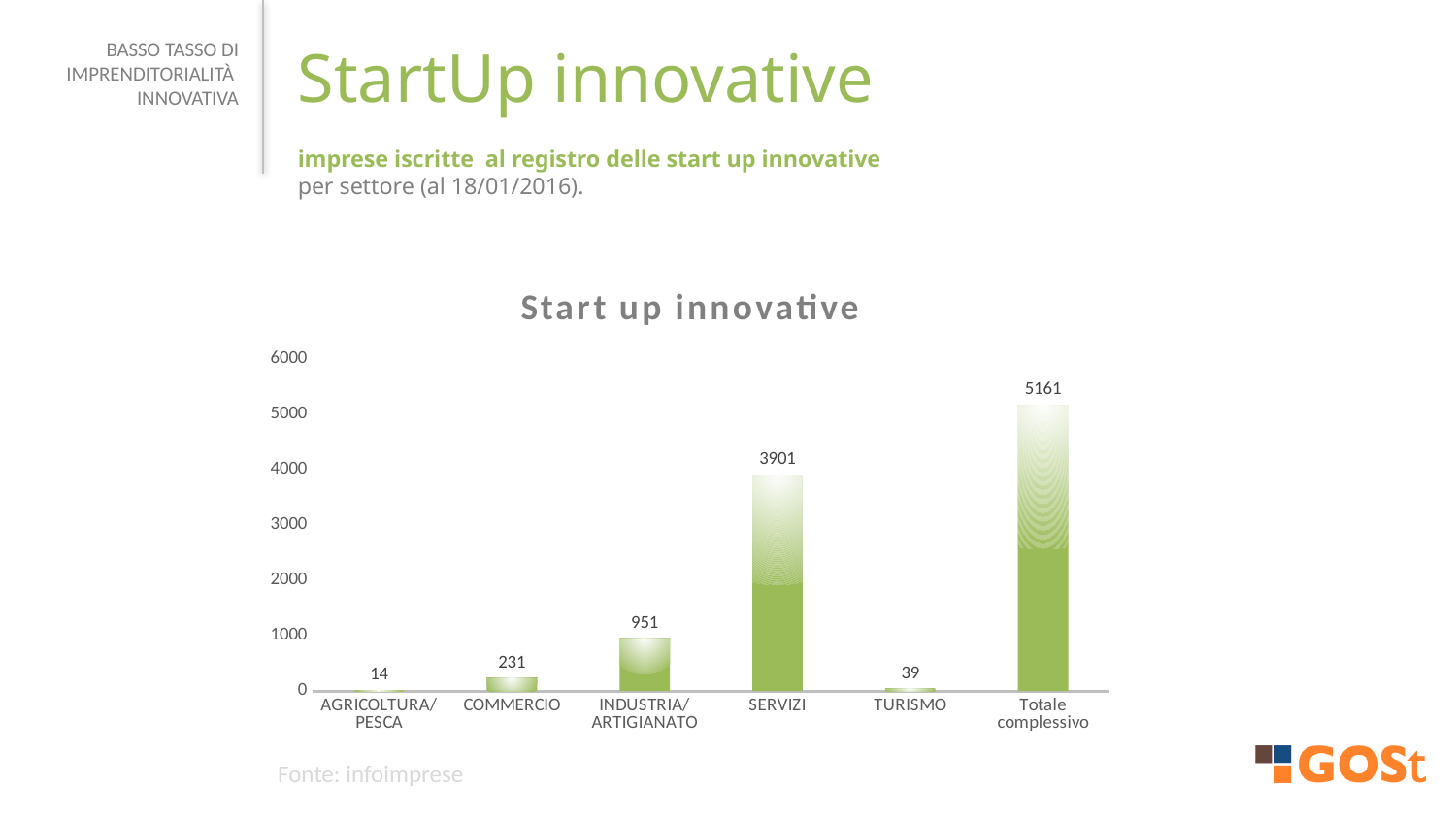
What is the value for INDUSTRIA/ARTIGIANATO? 951 Which sector (excluding the total) has the highest number of innovative start-ups? SERVIZI What is the value shown for Totale complessivo? 5161 What is the title of the chart? Start up innovative What is the value for AGRICOLTURA/PESCA? 14 Is the value for SERVIZI greater or less than 3000? greater What is the difference between the values for SERVIZI and INDUSTRIA/ARTIGIANATO? 2950 Which is larger, the value for COMMERCIO or the value for TURISMO? COMMERCIO What type of chart is shown on the slide? bar chart What is the value for SERVIZI in the Start up innovative chart? 3901 How many categories are shown on the x axis of the chart? 6 Which category has the lowest value in the chart? AGRICOLTURA/PESCA